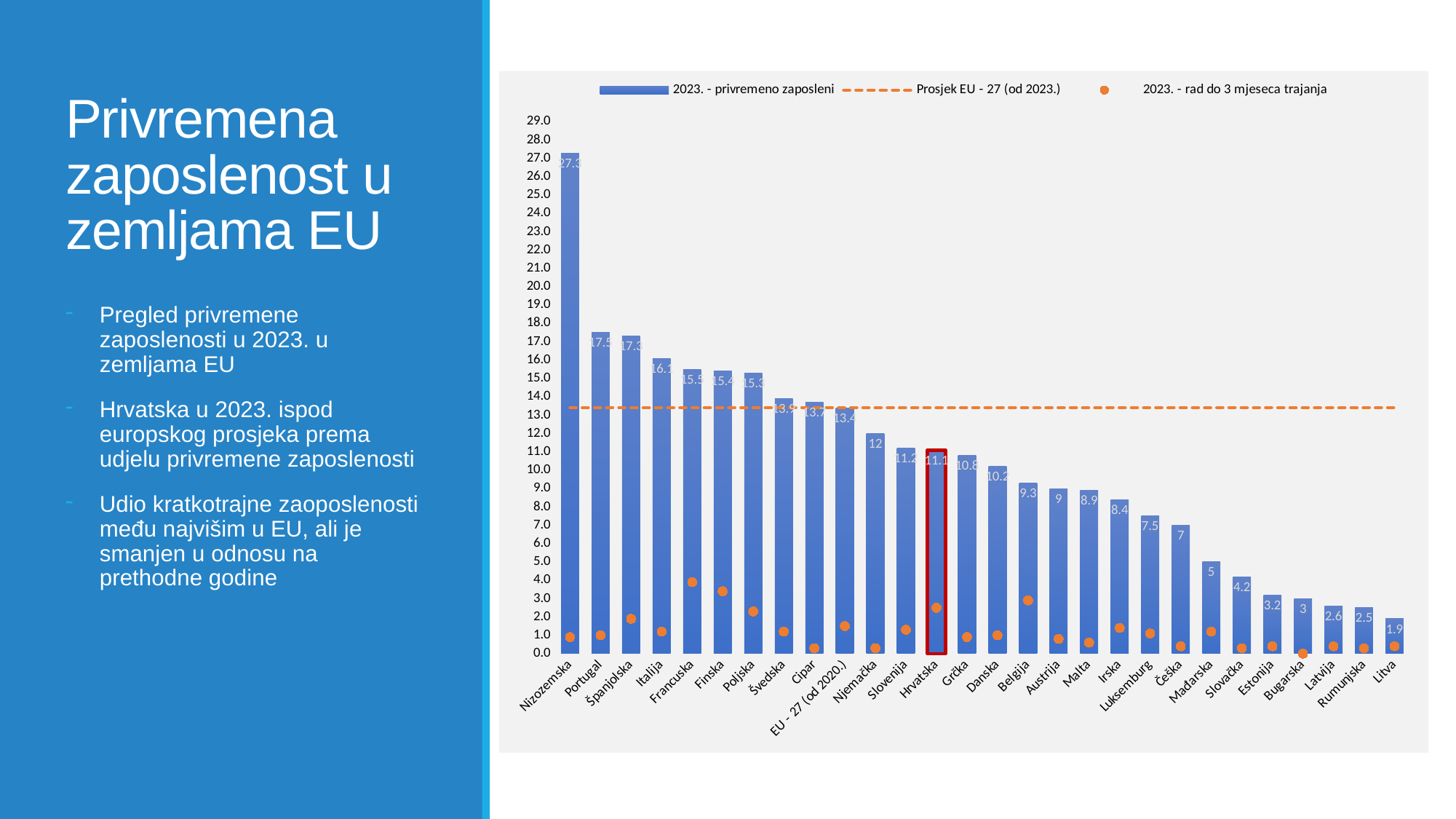
What is the value of the 2023. - privremeno zaposleni bar for EU - 27 (od 2020.)? 13.4 Do the 2023. - privremeno zaposleni bars rise or fall from left to right along the x axis? fall How many categories are shown on the x axis? 28 Which has a larger 2023. - privremeno zaposleni value, Njemačka or Grčka? Njemačka What is the difference between the 2023. - privremeno zaposleni values for Portugal and Hrvatska? 6.4 What is the value of the 2023. - privremeno zaposleni bar for Hrvatska? 11.1 What is the value of the 2023. - privremeno zaposleni bar for Nizozemska? 27.3 Which category has the highest 2023. - privremeno zaposleni bar? Nizozemska What kind of chart is shown on the slide? bar chart Is the 2023. - rad do 3 mjeseca trajanja value for Francuska greater or less than 3.0? greater Which category has the lowest 2023. - privremeno zaposleni bar? Litva How many series does the legend list? 3